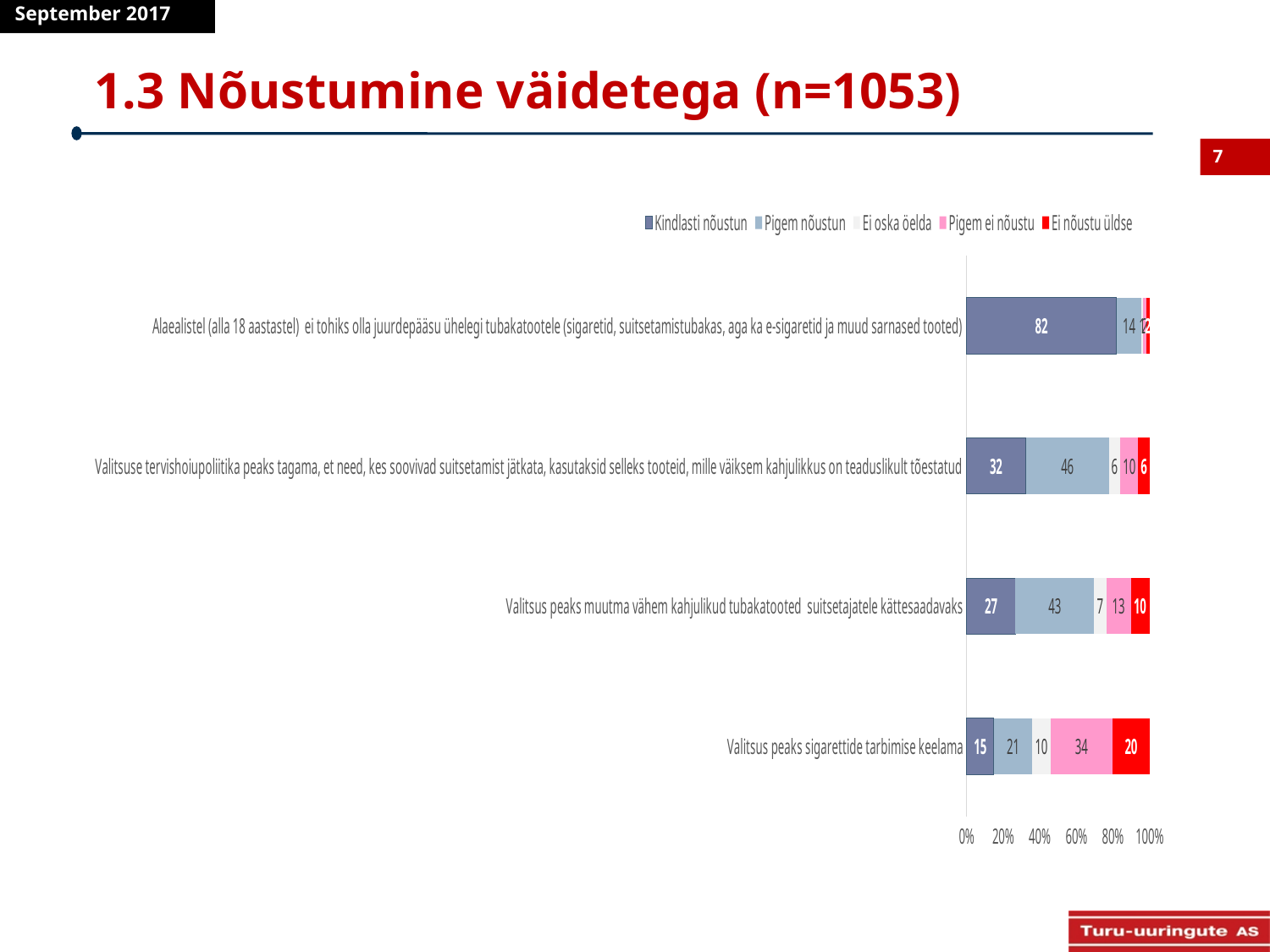
What is the 'Kindlasti nõustun' value for 'Valitsus peaks sigarettide tarbimise keelama'? 15 Which statement has the lowest 'Kindlasti nõustun' value? Valitsus peaks sigarettide tarbimise keelama Which statement has the highest 'Kindlasti nõustun' value? Alaealistel (alla 18 aastastel) ei tohiks olla juurdepääsu ühelegi tubakatootele (sigaretid, suitsetamistubakas, aga ka e-sigaretid ja muud sarnased tooted) Which is larger: the 'Ei nõustu üldse' value for 'Valitsus peaks sigarettide tarbimise keelama' or for 'Valitsus peaks muutma vähem kahjulikud tubakatooted suitsetajatele kättesaadavaks'? Valitsus peaks sigarettide tarbimise keelama What is the total of the 'Ei oska öelda' and 'Pigem ei nõustu' values for 'Valitsus peaks sigarettide tarbimise keelama'? 44 How many statements (categories) are shown in the chart? 4 What is the 'Pigem ei nõustu' value for 'Valitsus peaks sigarettide tarbimise keelama'? 34 What is the 'Pigem nõustun' value for 'Valitsuse tervishoiupoliitika peaks tagama, et need, kes soovivad suitsetamist jätkata, kasutaksid selleks tooteid, mille väiksem kahjulikkus on teaduslikult tõestatud'? 46 What kind of chart is shown on the slide? Stacked bar chart How many series does the legend list? 5 What is the 'Ei nõustu üldse' value for 'Valitsus peaks muutma vähem kahjulikud tubakatooted suitsetajatele kättesaadavaks'? 10 What is the difference between the 'Kindlasti nõustun' values for 'Valitsuse tervishoiupoliitika peaks tagama...' (32) and 'Valitsus peaks muutma vähem kahjulikud tubakatooted suitsetajatele kättesaadavaks' (27)? 5